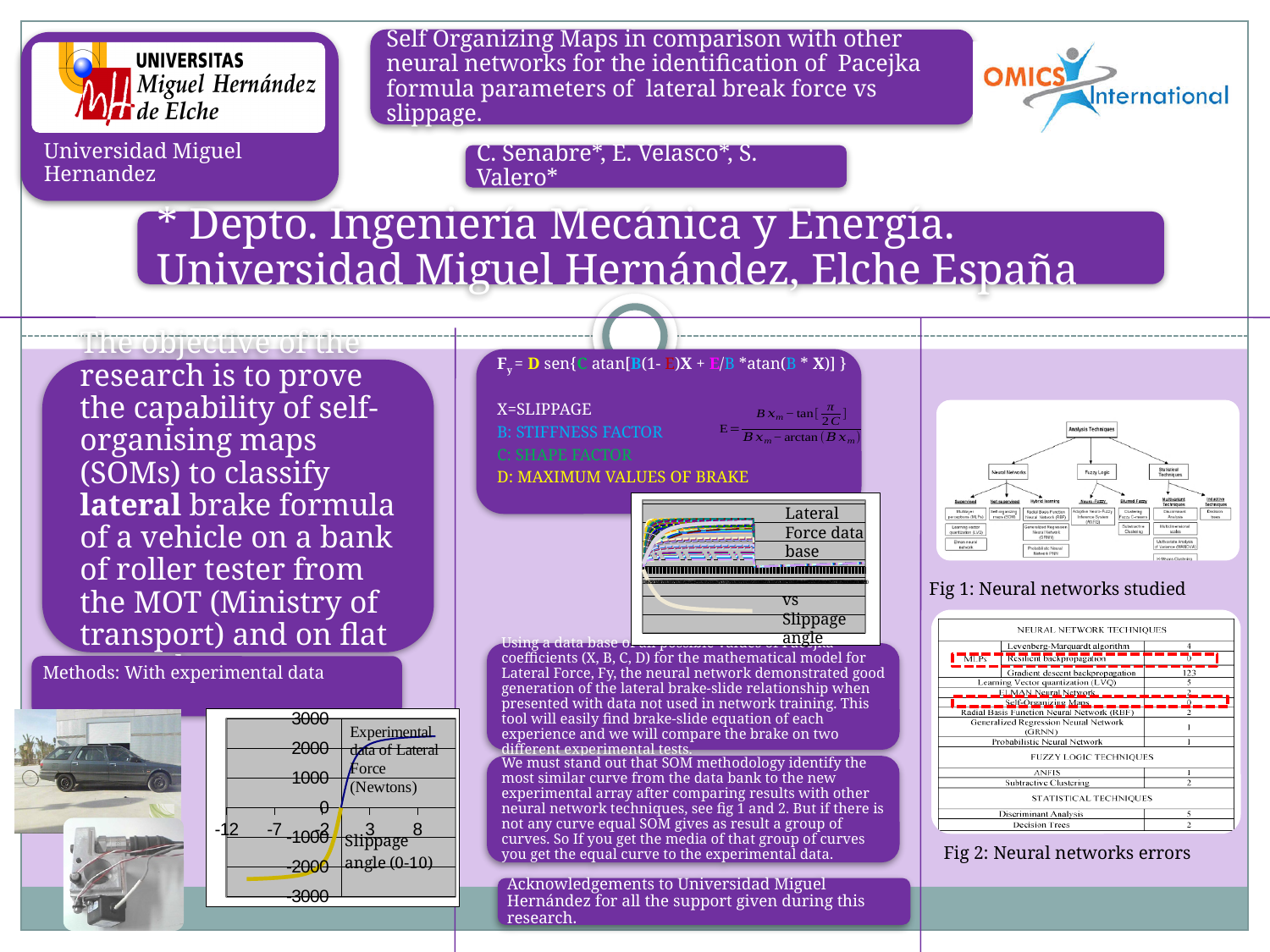
What is the highest tick value shown on the y axis of the bottom-left chart? 3000 In the bottom-left chart, is the lateral force value at a slippage angle of 8 greater or less than 1000? greater What unit is given for the lateral force in the bottom-left chart's label? Newtons In the bottom-left chart, which has the larger lateral force: slippage angle 8 or slippage angle -12? slippage angle 8 In the bottom-left chart, is the lateral force value at a slippage angle of 8 greater or less than 0? greater How many tick labels are shown on the x axis of the bottom-left chart? 5 In the bottom-left chart, is the lateral force value at a slippage angle of -12 greater or less than 0? less In the bottom-left chart, do the lateral force values rise or fall as the slippage angle increases along the x axis? rise What kind of chart is the chart at the bottom left of the slide? line chart